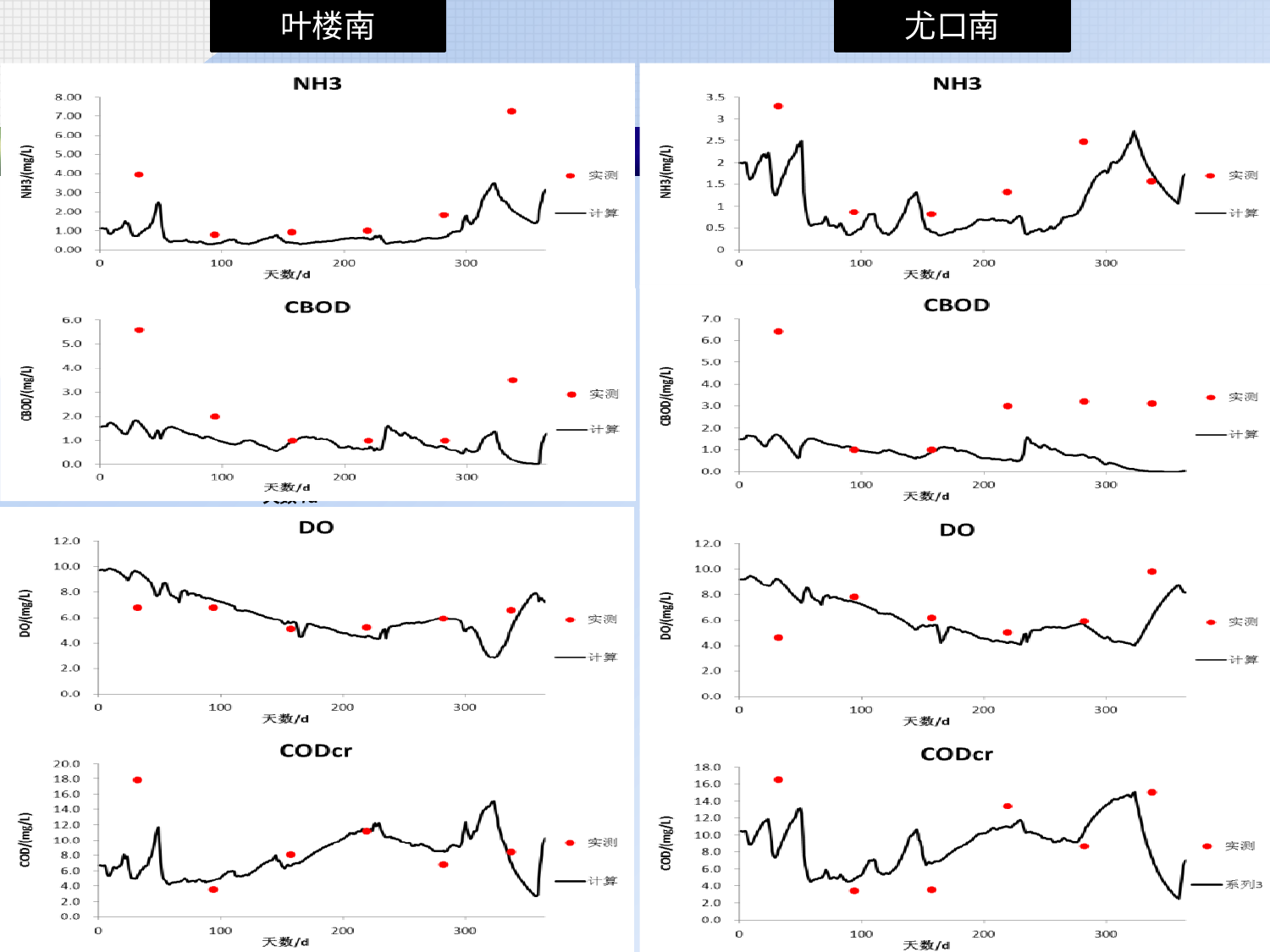
In the 尤口南 DO chart, is the 实测 value near day 340 greater or less than 8.0? greater In the 尤口南 NH3 chart, is the 实测 value near day 30 greater or less than 3? greater In the 叶楼南 DO chart, is the 计算 line at day 0 greater or less than 8.0? greater In the 尤口南 NH3 chart, how many 实测 points are plotted? 6 In the 尤口南 CODcr chart, what label does the legend give to the line series? 系列3 In the 叶楼南 NH3 chart, what are the two legend entries? 实测 and 计算 What kind of chart is the 叶楼南 DO chart? line chart In the 叶楼南 NH3 chart, how many series does the legend list? 2